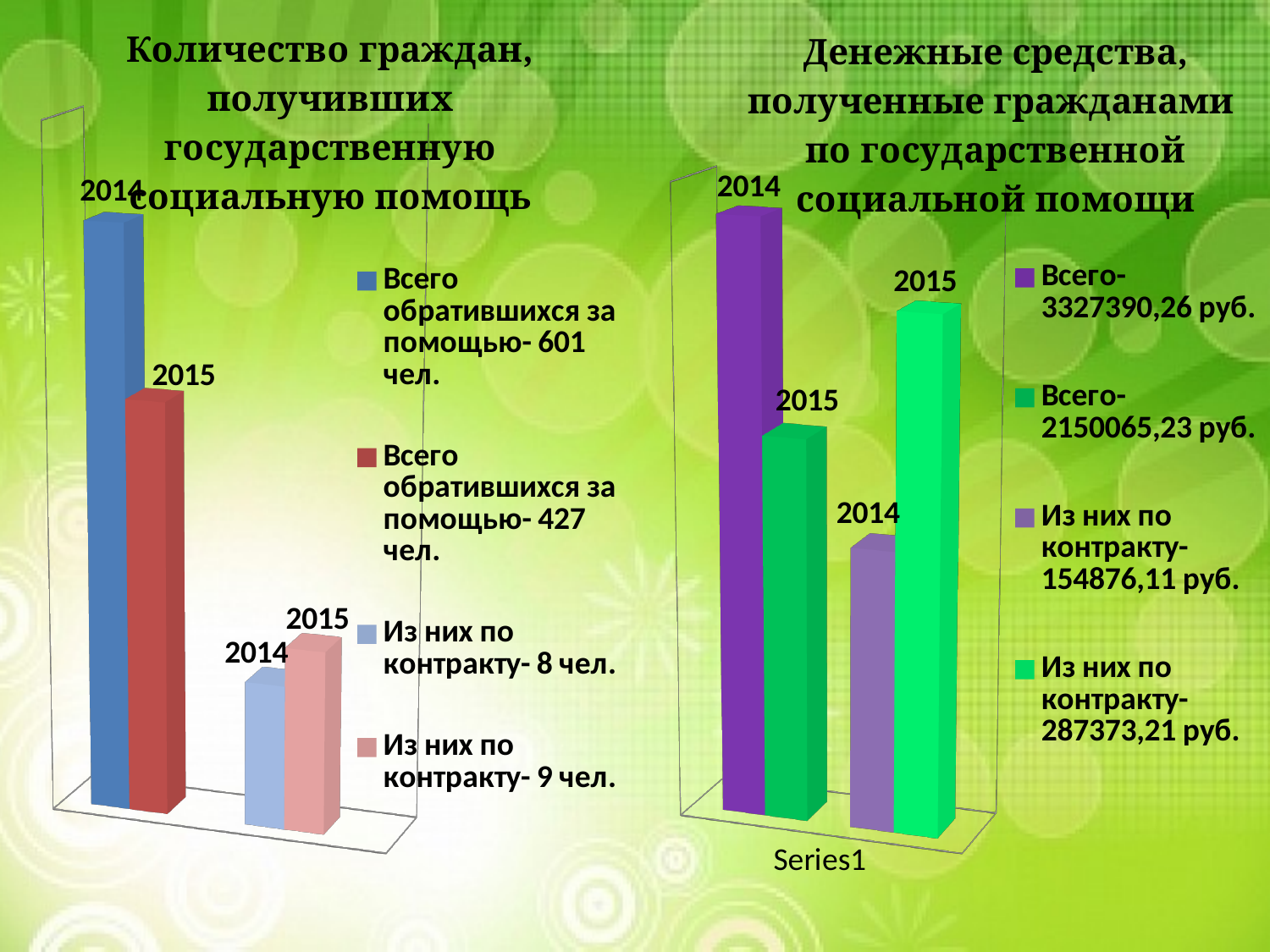
In the right chart, which bar is the shortest? 2014 (Из них по контракту- 154876,11 руб.) In the left chart, which bar is the tallest? 2014 (Всего обратившихся за помощью- 601 чел.) In the left chart, what value does the legend give for 'Всего обратившихся за помощью' in 2014 (the blue bar)? 601 чел. In the left chart, how many bars are plotted? 4 In the left chart, which is larger: 'Из них по контракту' in 2014 (8 чел.) or in 2015 (9 чел.)? 2015 (9 чел.) In the right chart, what is the label shown below the bars on the horizontal axis? Series1 In the right chart, 'Денежные средства, полученные гражданами по государственной социальной помощи', what value does the legend give for 'Всего' in 2014 (the purple bar)? 3327390,26 руб. What kind of chart is the left chart, 'Количество граждан, получивших государственную социальную помощь'? bar chart In the left chart, what is the difference between the total number of applicants in 2014 (601) and in 2015 (427)? 174 чел. In the left chart, what value does the legend give for 'Всего обратившихся за помощью' in 2015 (the red bar)? 427 чел. In the left chart, how many entries does the legend list? 4 In the right chart, what value does the legend give for 'Из них по контракту' in 2015 (the bright green bar)? 287373,21 руб.